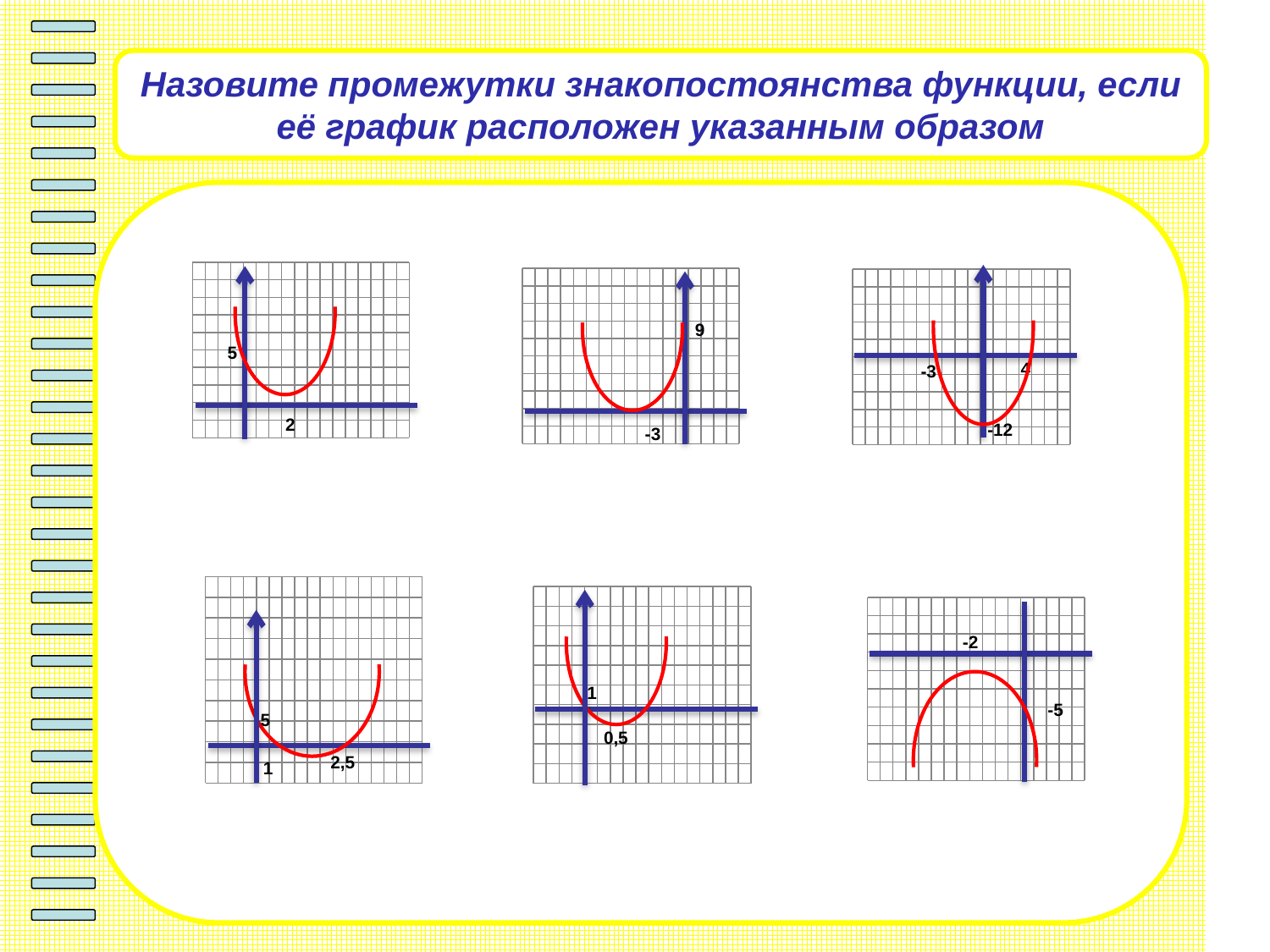
What kind of curve is drawn in each of the six graphs? parabola In the bottom-left graph, at which two x values does the parabola cross the x-axis? 1 and 2,5 In the top-right graph, what value is marked at the vertex of the parabola? -12 How many function graphs are shown on the slide? 6 In the top-middle graph, what value is marked on the y-axis where the parabola crosses it? 9 In the top-left graph, at which x value does the parabola touch the x-axis? 2 How many of the six parabolas open downward? 1 In the bottom-right graph, what value is marked on the y-axis? -5 What colour are the curves drawn in the graphs? red Which graph on the slide shows a parabola opening downward? bottom-right In the bottom-middle graph, what value is marked on the y-axis where the parabola crosses it? 1 In the top-right graph, at which two x values does the parabola cross the x-axis? -3 and 4